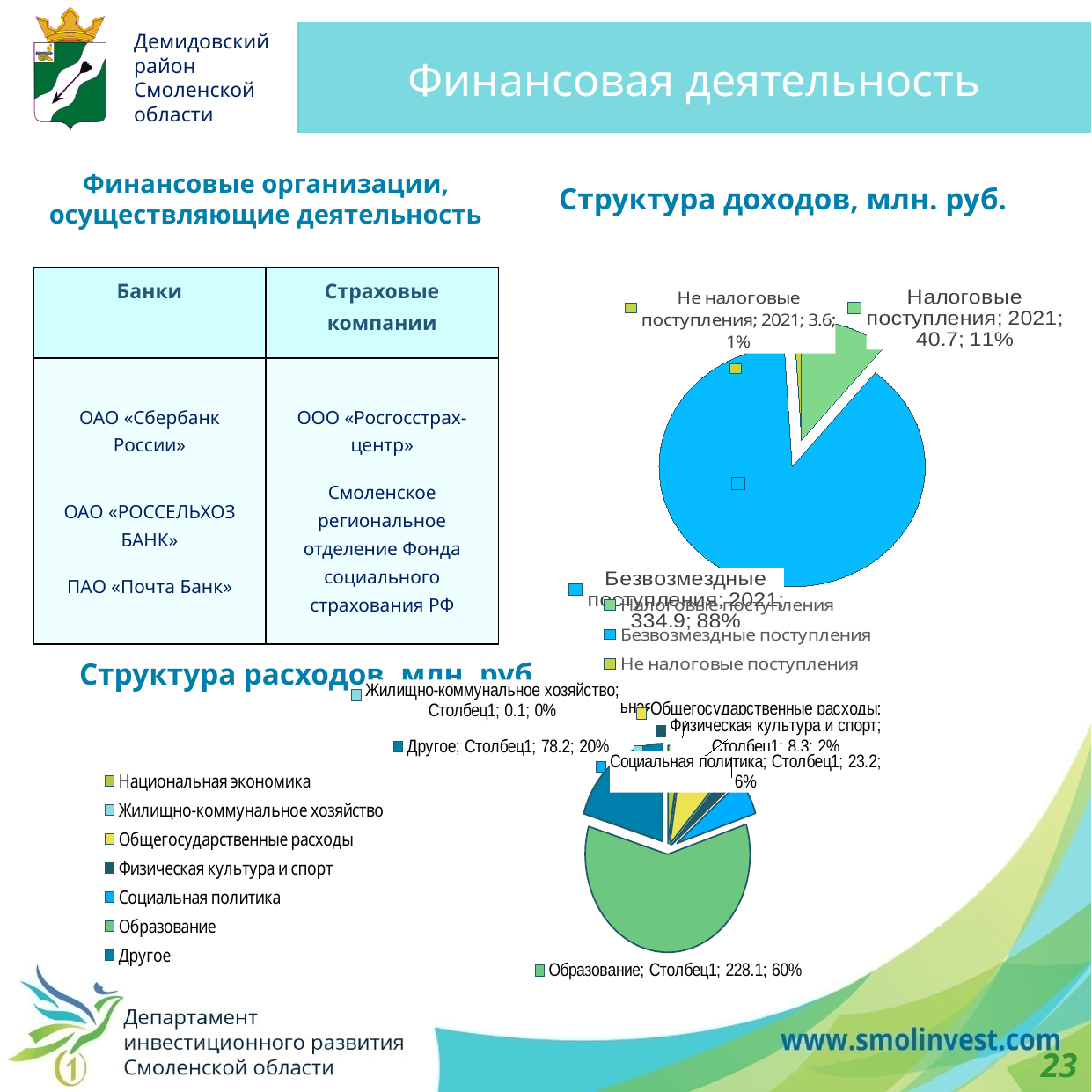
In the chart 'Структура доходов, млн. руб.', what is the value for Безвозмездные поступления? 334.9 In the chart 'Структура доходов, млн. руб.', which category is the largest? Безвозмездные поступления What kind of chart is 'Структура расходов, млн. руб.'? Pie chart In the chart 'Структура расходов, млн. руб.', what share of the pie is Другое? 20% In the chart 'Структура доходов, млн. руб.', which category is the smallest? Не налоговые поступления How many entries does the legend of the chart 'Структура расходов, млн. руб.' list? 7 In the chart 'Структура доходов, млн. руб.', what is the difference between Налоговые поступления and Не налоговые поступления? 37.1 In the chart 'Структура расходов, млн. руб.', which is larger: Социальная политика or Физическая культура и спорт? Социальная политика How many entries does the legend of the chart 'Структура доходов, млн. руб.' list? 3 In the chart 'Структура доходов, млн. руб.', what share of the pie is Не налоговые поступления? 1% In the chart 'Структура расходов, млн. руб.', what is the value for Образование? 228.1 In the chart 'Структура доходов, млн. руб.', what is the value for Налоговые поступления? 40.7